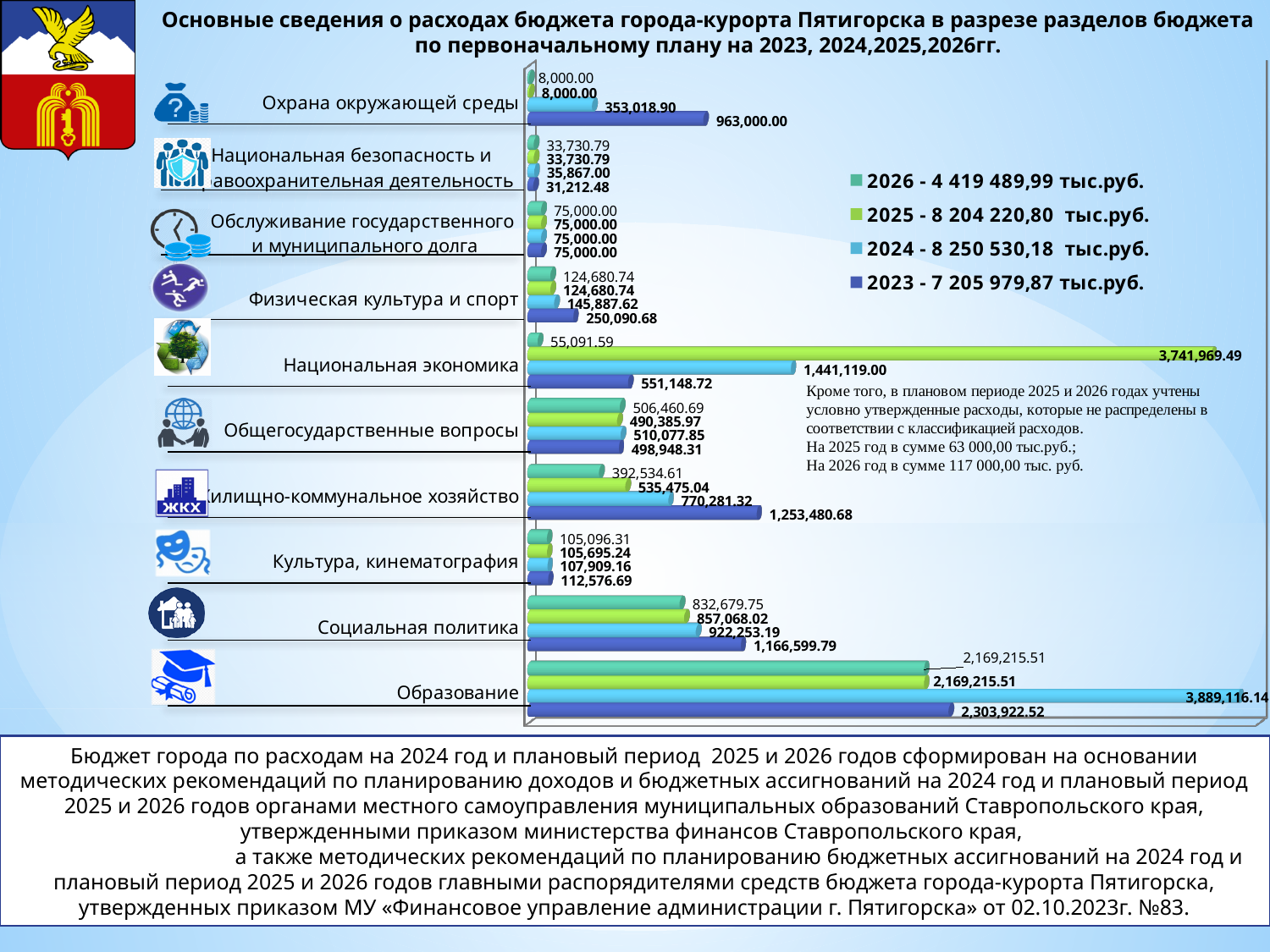
Which category has the lowest 2023 value? Национальная безопасность и правоохранительная деятельность What is the 2026 value for Обслуживание государственного и муниципального долга? 75,000.00 What kind of chart is shown on the slide? Bar chart What is the 2023 value for Охрана окружающей среды? 963,000.00 Which is larger for 2023: Социальная политика or Жилищно-коммунальное хозяйство? Жилищно-коммунальное хозяйство According to the legend, what is the total for 2024? 8 250 530,18 тыс.руб. How many budget sections (categories) are shown in the chart? 10 What is the 2024 value for Образование? 3,889,116.14 What is the 2025 value for Национальная экономика? 3,741,969.49 How many series does the chart legend list? 4 Which category has the highest 2023 value? Образование What is the difference between the 2024 and 2023 values for Образование? 1,585,193.62